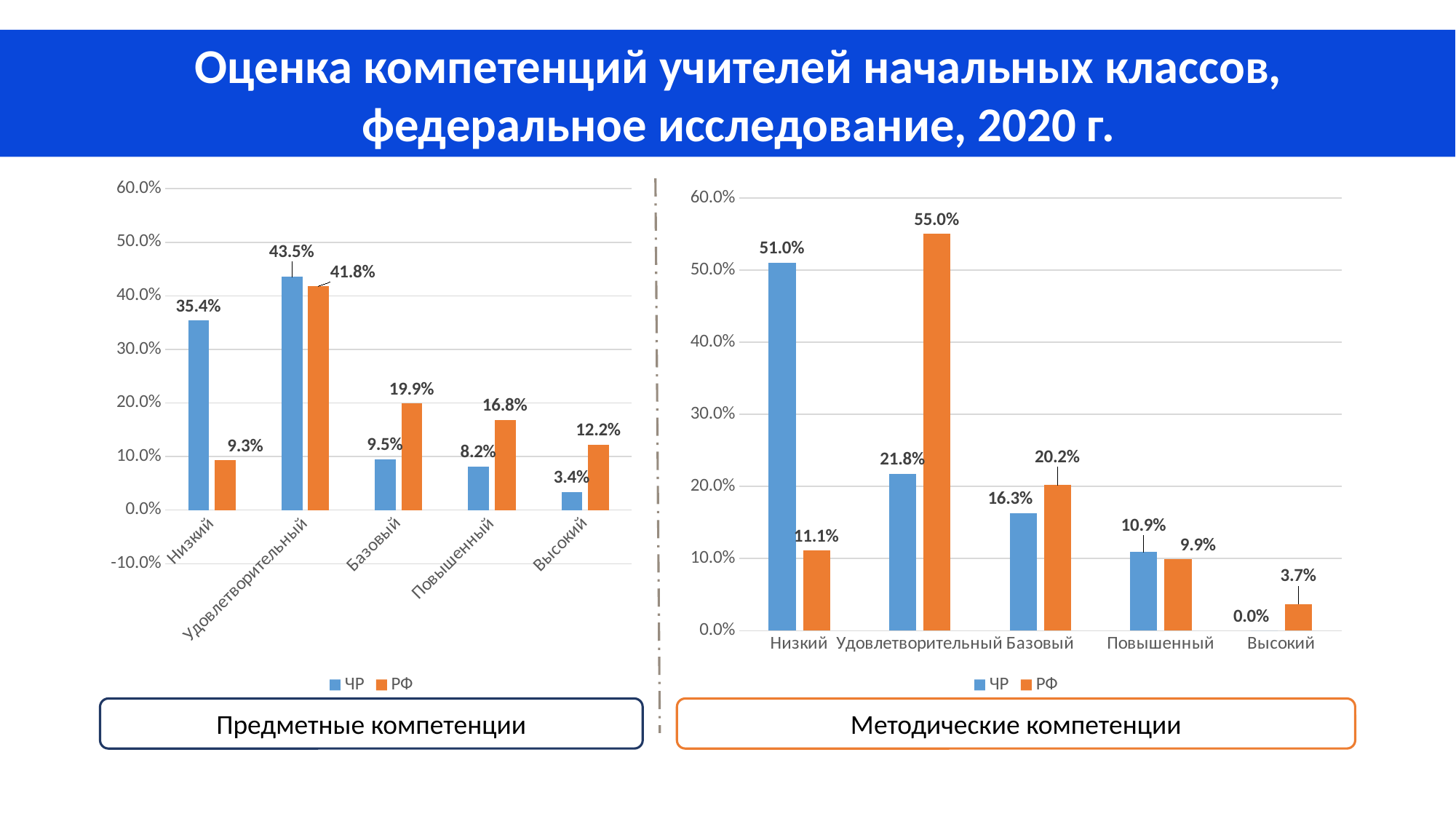
In the 'Методические компетенции' chart, which category has the lowest value for ЧР? Высокий In the 'Методические компетенции' chart, which is larger in the Базовый category, ЧР or РФ? РФ How many categories are shown on the x axis of the 'Методические компетенции' chart? 5 In the 'Предметные компетенции' chart, what is the difference between ЧР and РФ in the Высокий category? 8.8% In the 'Предметные компетенции' chart, what is the value for ЧР in the Низкий category? 35.4% In the 'Предметные компетенции' chart, which category has the highest value for РФ? Удовлетворительный In the 'Методические компетенции' chart, what is the difference between РФ and ЧР in the Низкий category? 39.9% In the 'Методические компетенции' chart, what is the value for ЧР in the Удовлетворительный category? 21.8% In the 'Предметные компетенции' chart, what is the value for РФ in the Базовый category? 19.9% How many series does the legend of the 'Предметные компетенции' chart list? 2 In the 'Методические компетенции' chart, what is the value for РФ in the Высокий category? 3.7% In the 'Предметные компетенции' chart, which is larger in the Повышенный category, ЧР or РФ? РФ